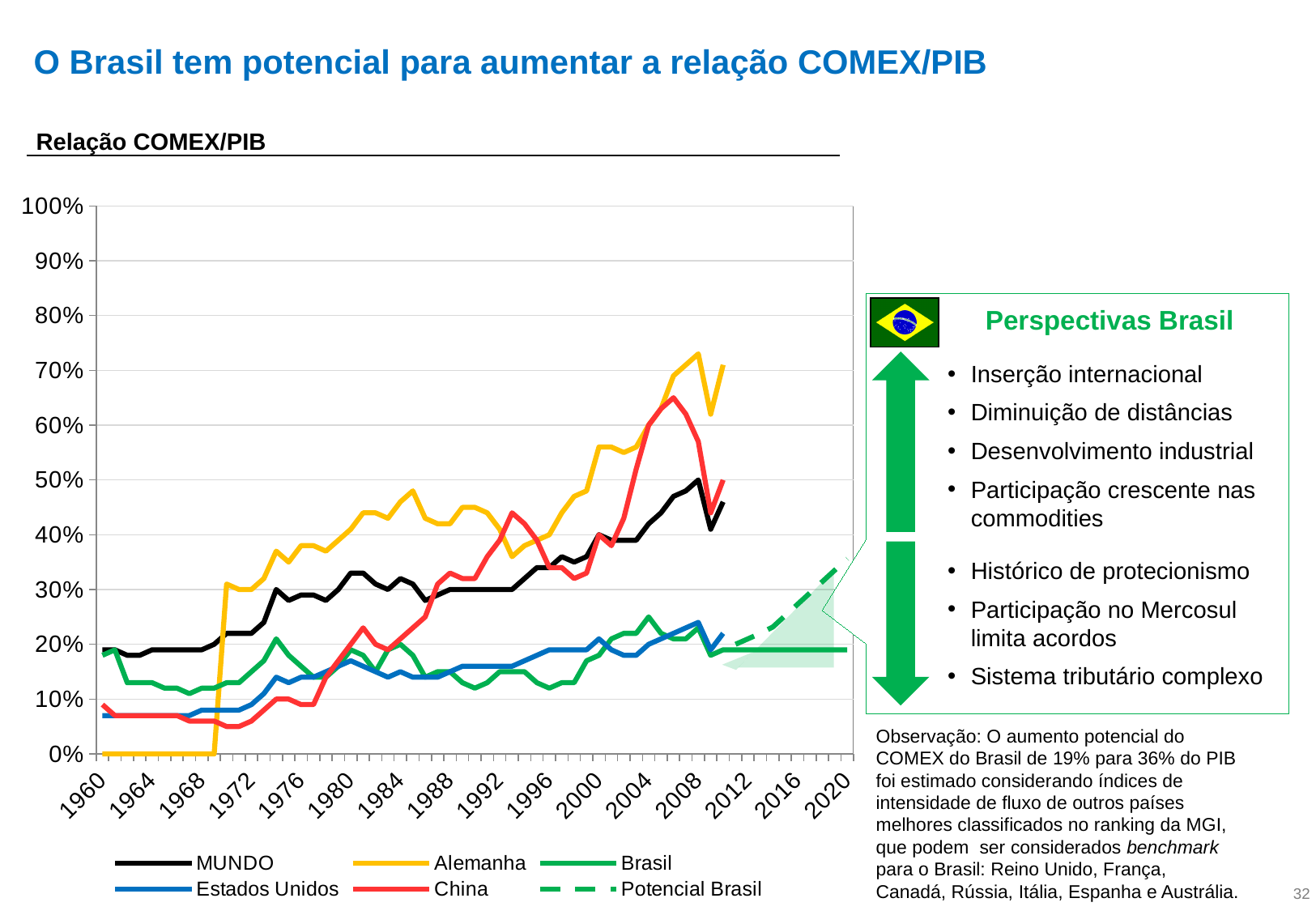
Which series reaches the highest value anywhere on the chart? Alemanha Is the value for China in 2008 greater or less than 50%? greater In 2004, which is larger: the value for MUNDO or the value for Estados Unidos? MUNDO What kind of chart is shown on the slide? line chart Which series is drawn as a dashed line in the legend? Potencial Brasil Does the MUNDO series generally rise or fall from 1960 to 2008? rise Is the value for Estados Unidos in 1960 greater or less than 10%? less How many series does the chart legend list? 6 Is the value for Alemanha in 2008 greater or less than 60%? greater What is the title of the chart? Relação COMEX/PIB